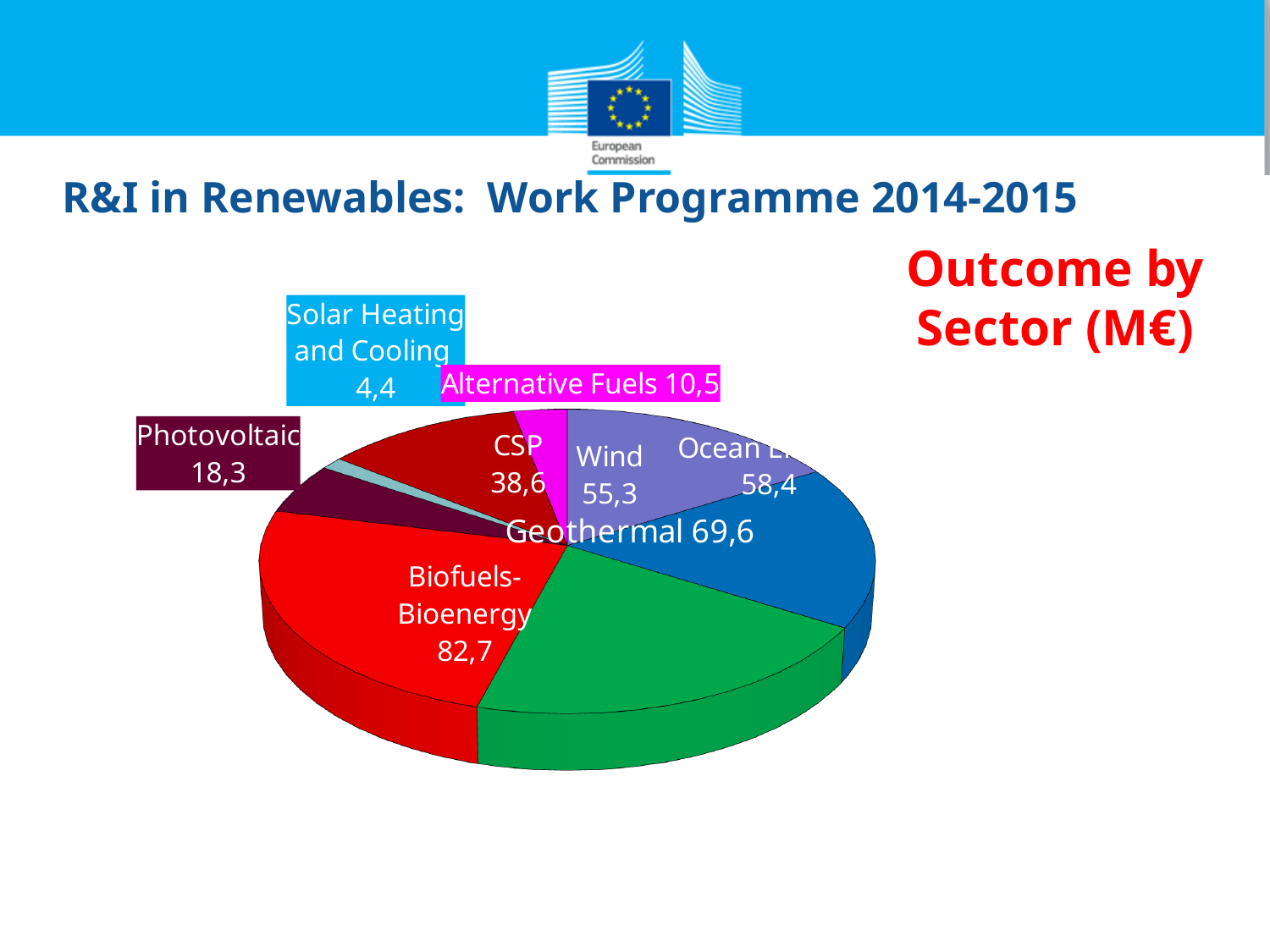
What is the value for Geothermal in the pie chart? 69,6 What is the value for Photovoltaic in the pie chart? 18,3 What is the value for Biofuels-Bioenergy in the pie chart? 82,7 What is the difference between the values for Biofuels-Bioenergy and Geothermal? 13,1 How many slices does the pie chart have? 8 Which has a larger value, Wind or CSP? Wind Which sector has the largest value in the pie chart? Biofuels-Bioenergy What is the value for Wind in the pie chart? 55,3 What is the value for Alternative Fuels in the pie chart? 10,5 What is the value for CSP in the pie chart? 38,6 What type of chart is shown on the slide? Pie chart Which sector has the smallest value in the pie chart? Solar Heating and Cooling